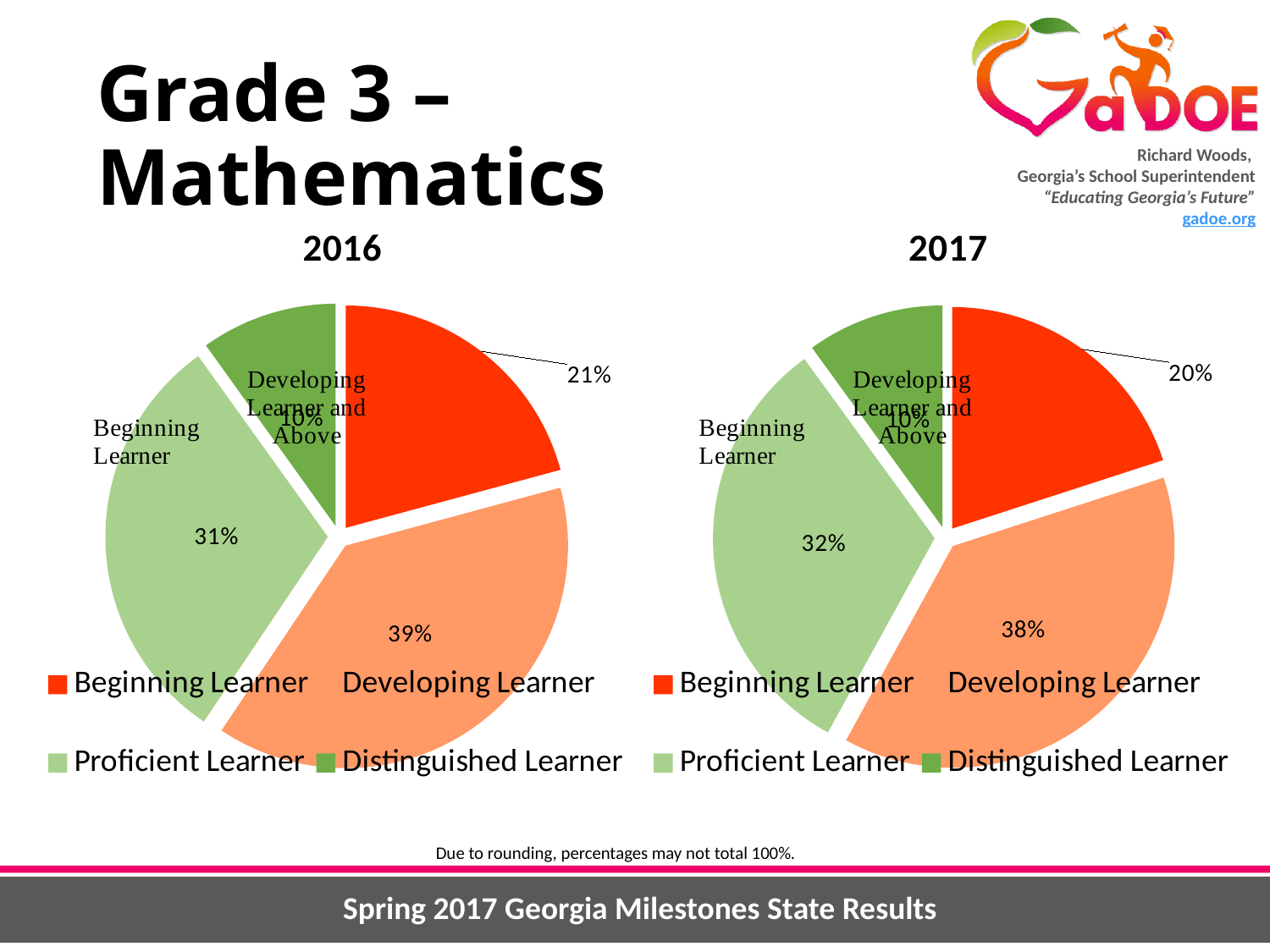
In the 2016 pie chart, what percentage is shown for Proficient Learner? 31% What kind of chart is used for the 2016 data? Pie chart What is the title of the chart on the right side of the slide? 2017 In the 2017 pie chart, what percentage is shown for Distinguished Learner? 10% In the 2017 pie chart, what is the difference between the Developing Learner and Proficient Learner percentages? 6% In the 2017 pie chart, which category has the smallest share? Distinguished Learner In the 2016 pie chart, which is larger, Beginning Learner or Proficient Learner? Proficient Learner In the 2016 pie chart, what percentage is shown for Beginning Learner? 21% How many entries does the legend of the 2016 chart list? 4 In the 2017 pie chart, what percentage is shown for Developing Learner? 38% How many slices does the 2017 pie chart have? 4 In the 2016 pie chart, which category has the largest share? Developing Learner